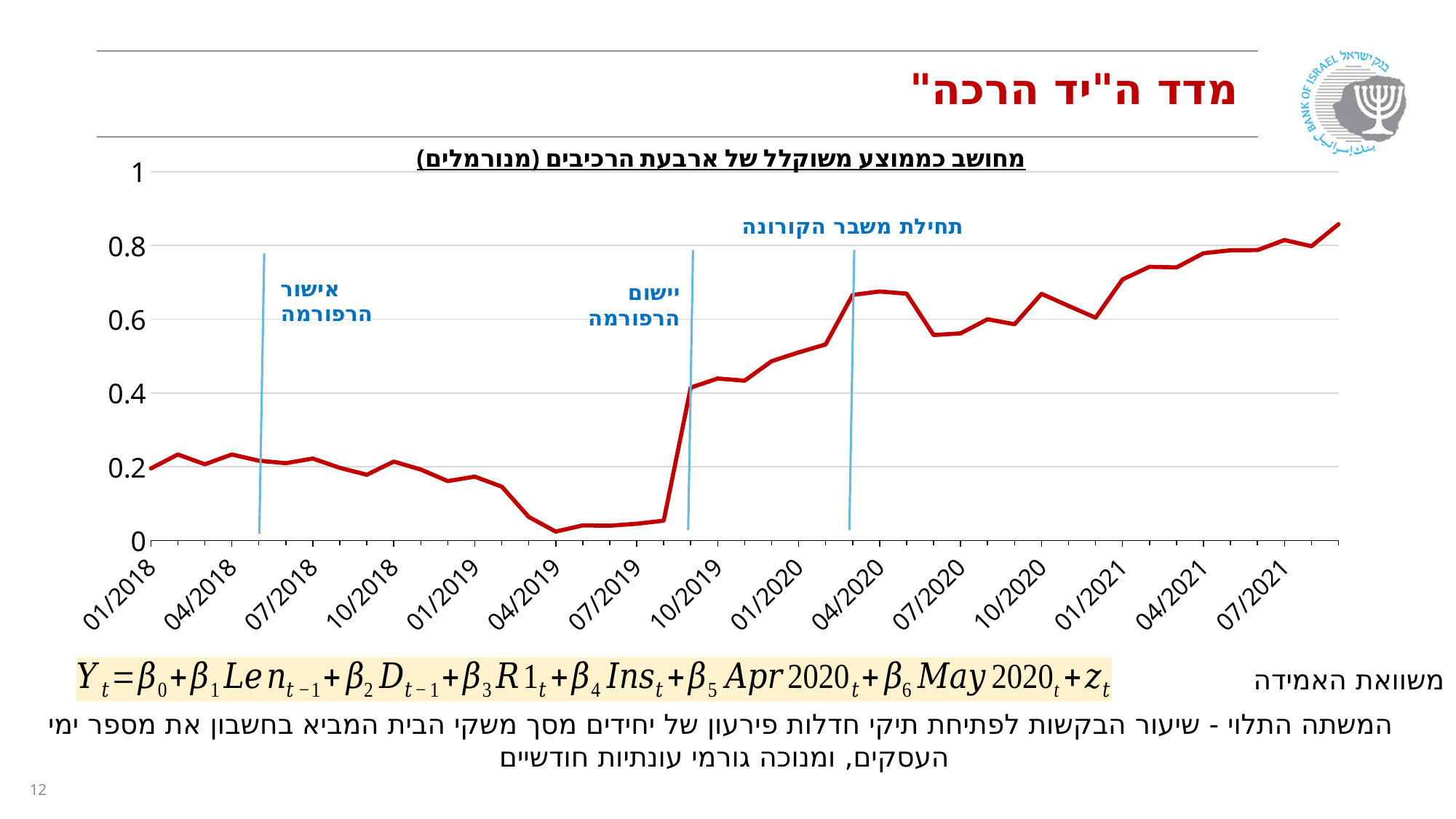
Does the index rise or fall between 01/2019 and 04/2019? fall Is the value of the index at 01/2020 greater or less than 0.6? less What is the title of the slide's chart? מדד ה"יד הרכה" Is the value of the index at 04/2021 greater or less than 0.6? greater Is the value of the index at 04/2020 greater or less than 0.6? greater Around which x-axis date does the index reach its lowest point? 04/2019 What kind of chart is shown on the slide? line chart Does the index rise or fall between 07/2019 and 10/2019? rise Which is larger, the index value at 04/2019 or at 04/2020? 04/2020 How many vertical event marker lines are drawn on the chart? 3